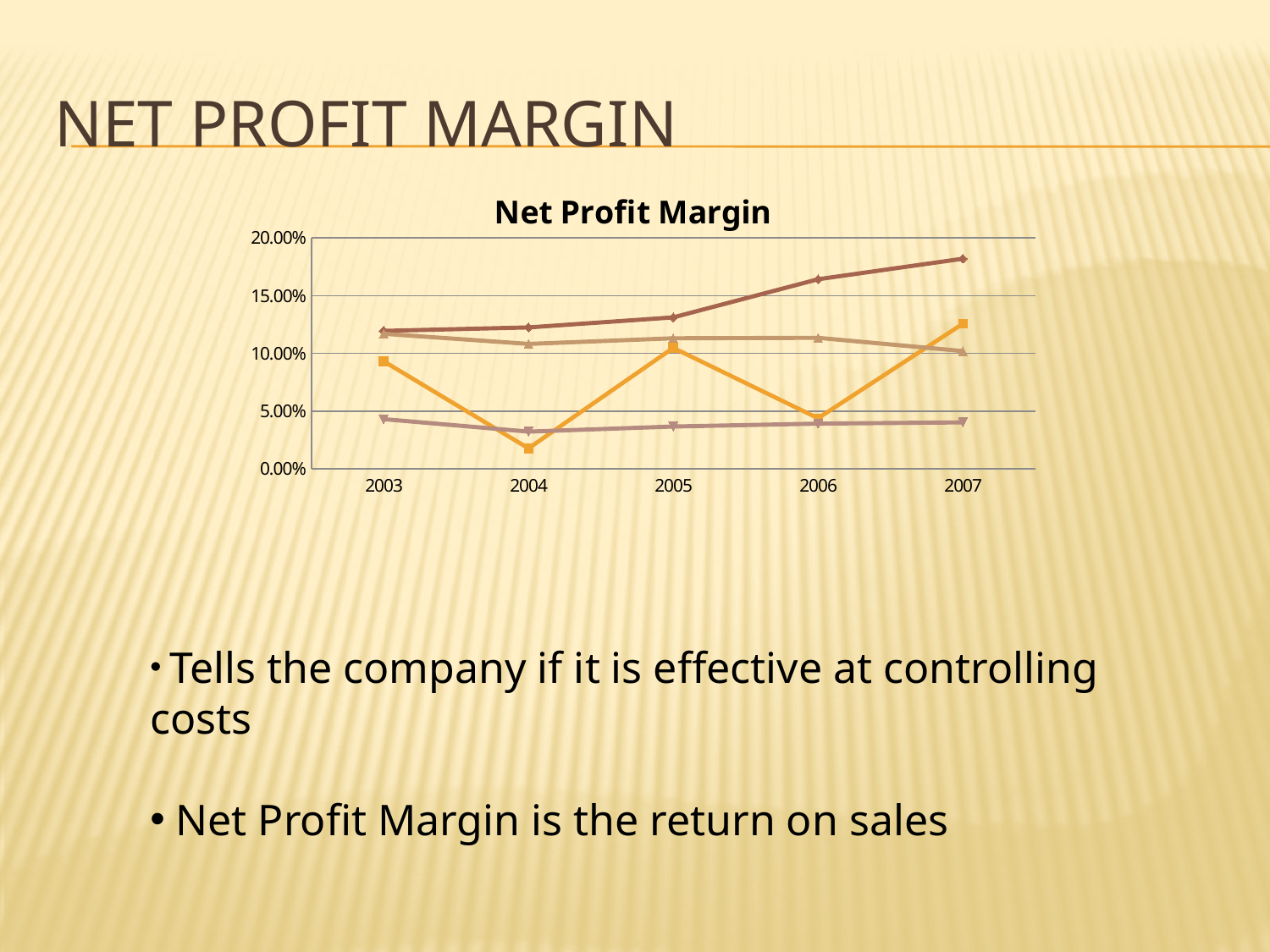
In 2007, which is higher: the dark brown line with diamond markers or the orange line with square markers? the dark brown line with diamond markers What kind of chart is shown on the slide? line chart How many years are shown on the x axis of the chart? 5 In which year does the dark brown line with diamond markers reach its highest value? 2007 How many lines are plotted on the chart? 4 Is the value of the dark brown line with diamond markers in 2007 greater or less than 15.00%? greater Is the value of the orange line with square markers in 2007 greater or less than 10.00%? greater In which year does the orange line with square markers reach its lowest value? 2004 Does the dark brown line with diamond markers rise or fall from 2003 to 2007? rise Is the value of the dark brown line with diamond markers in 2006 greater or less than 15.00%? greater What is the title of the chart? Net Profit Margin